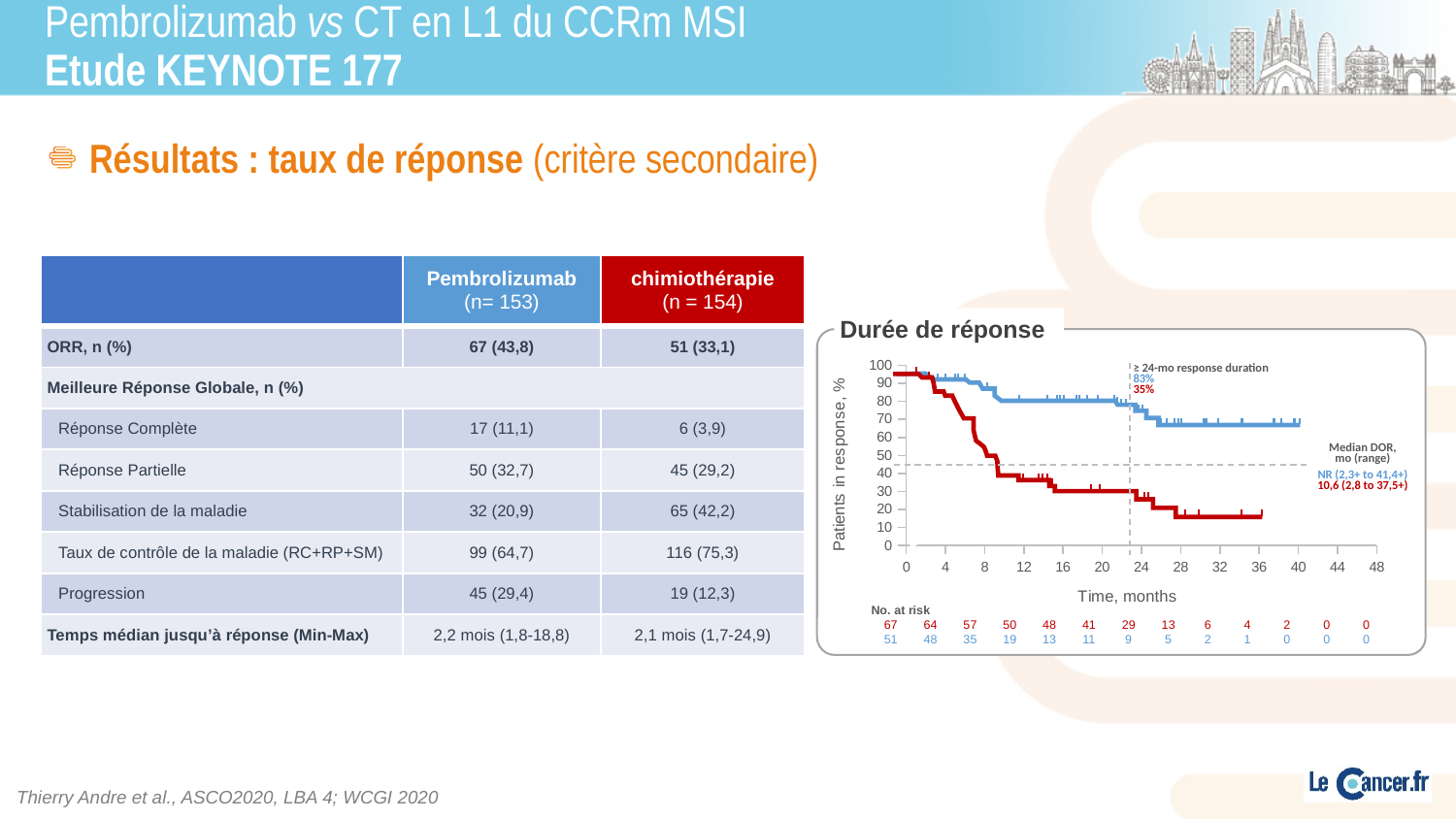
In the "Durée de réponse" chart, what percentage of patients on the red curve have a response duration of 24 months or more? 35% In the "Durée de réponse" chart, do the curves rise or fall as time in months increases? Fall In the "Durée de réponse" chart, what is the median DOR printed for the blue curve? NR (2,3+ to 41,4+) What kind of chart is shown under the title "Durée de réponse"? Line chart (Kaplan-Meier curve) In the "Durée de réponse" chart, what is the difference between the ≥24-month response duration percentages of the blue and red curves? 48 percentage points In the "Durée de réponse" chart, what percentage of patients on the blue curve have a response duration of 24 months or more? 83% In the "Durée de réponse" chart, what is the label of the y axis? Patients in response, % In the "Durée de réponse" chart, how many patients are at risk at time 0 for the blue curve? 67 In the "Durée de réponse" chart, what is the median DOR printed for the red curve? 10,6 (2,8 to 37,5+) What is the title of the chart on the slide? Durée de réponse In the "Durée de réponse" chart, how many patients are at risk at 12 months for the red curve? 19 In the "Durée de réponse" chart, which curve shows the higher proportion of patients still in response at 24 months, the blue or the red? Blue